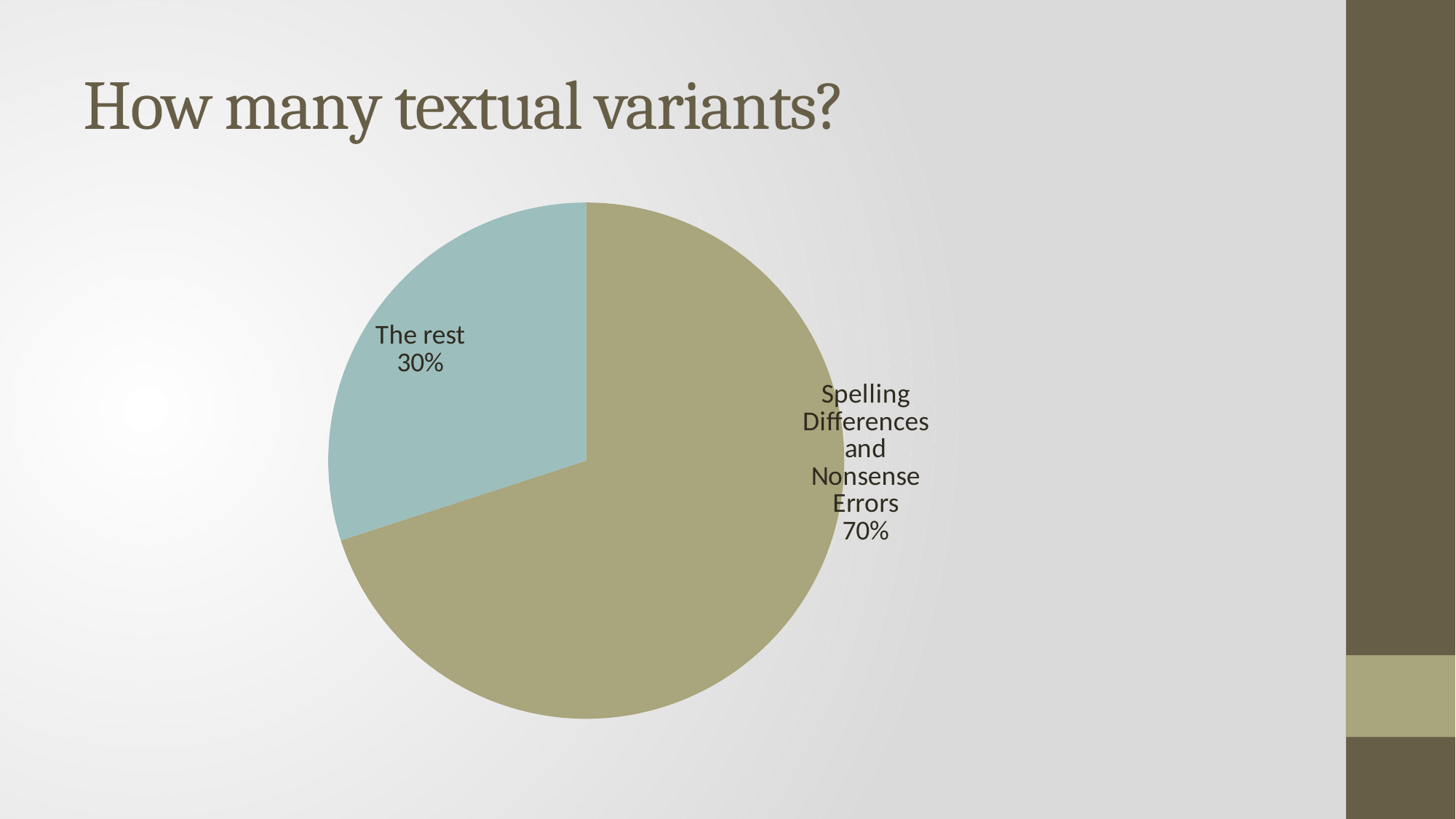
What is the title of the slide containing the pie chart? How many textual variants? How many slices does the pie chart have? 2 What colour is the slice labelled "The rest"? light blue What kind of chart is shown on the slide? pie chart What share of the pie is labelled "Spelling Differences and Nonsense Errors"? 70% Which slice of the pie is the largest? Spelling Differences and Nonsense Errors What is the difference in percentage points between the "Spelling Differences and Nonsense Errors" slice and "The rest" slice? 40 Which slice of the pie is the smallest? The rest What share of the pie is labelled "The rest"? 30% Which is larger: the "Spelling Differences and Nonsense Errors" slice or "The rest" slice? Spelling Differences and Nonsense Errors